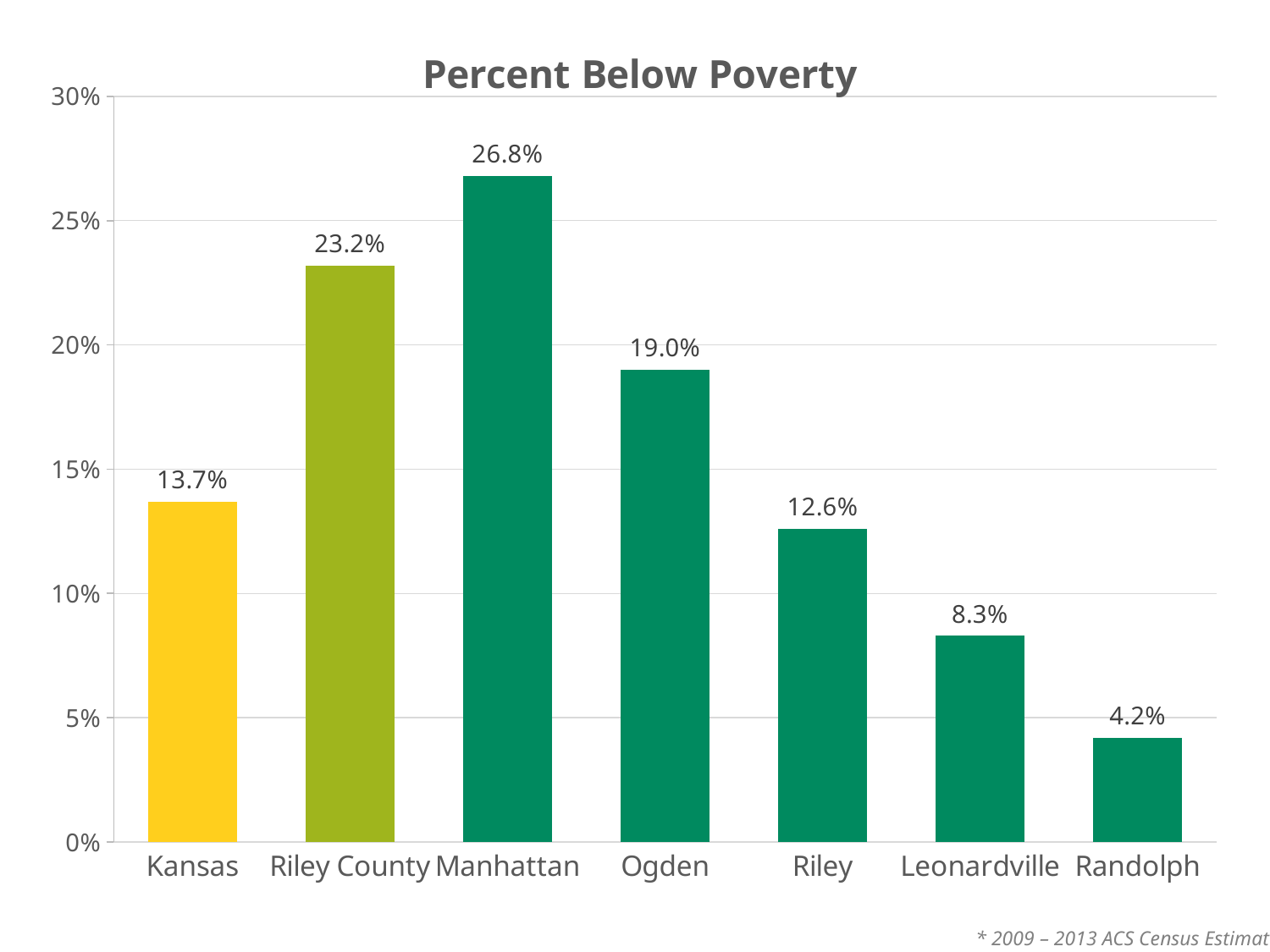
Which has a higher percent below poverty, Ogden or Riley? Ogden Is the value for Riley County greater or less than 20%? greater How many categories are shown on the chart? 7 What is the percent below poverty for Leonardville? 8.3% What is the title of the chart? Percent Below Poverty Which category has the highest percent below poverty? Manhattan What kind of chart is shown on the slide? Bar chart What is the percent below poverty for Manhattan? 26.8% Which category has the lowest percent below poverty? Randolph What is the percent below poverty for Kansas? 13.7% What is the difference between the percent below poverty for Riley County and Kansas? 9.5% What is the difference between the percent below poverty for Ogden and Riley? 6.4%